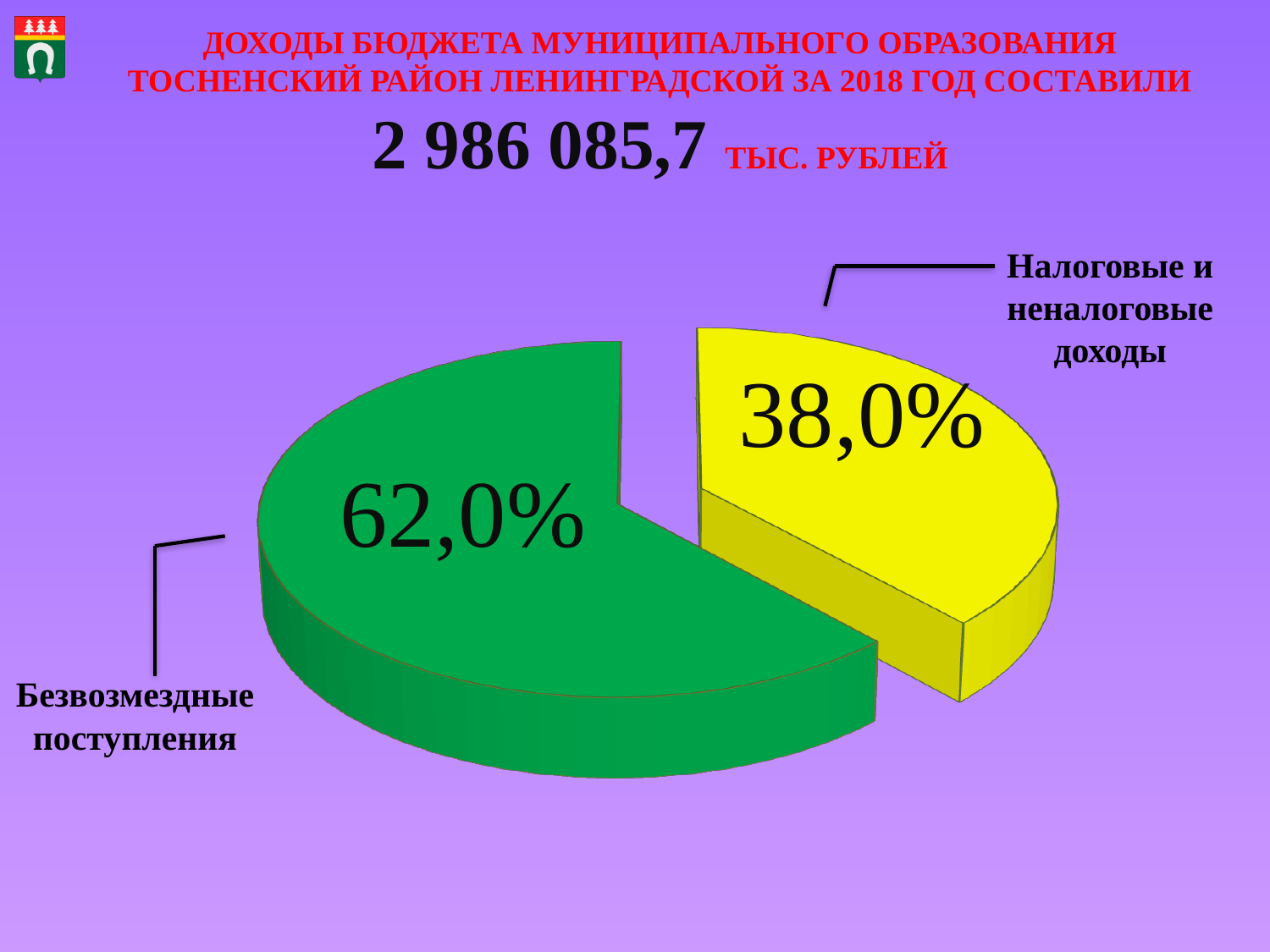
Which slice of the pie is the largest? Безвозмездные поступления What colour is the "Налоговые и неналоговые доходы" slice? yellow What total budget income amount is stated on the slide for 2018? 2 986 085,7 тыс. рублей What share of the pie does "Безвозмездные поступления" represent? 62,0% Which is larger: the share for "Налоговые и неналоговые доходы" or the share for "Безвозмездные поступления"? Безвозмездные поступления What colour is the "Безвозмездные поступления" slice? green What kind of chart is shown on the slide? pie chart How many slices does the pie chart have? 2 What is the difference in percentage points between the "Безвозмездные поступления" slice and the "Налоговые и неналоговые доходы" slice? 24,0% What share of the pie does "Налоговые и неналоговые доходы" represent? 38,0% Which slice of the pie is the smallest? Налоговые и неналоговые доходы